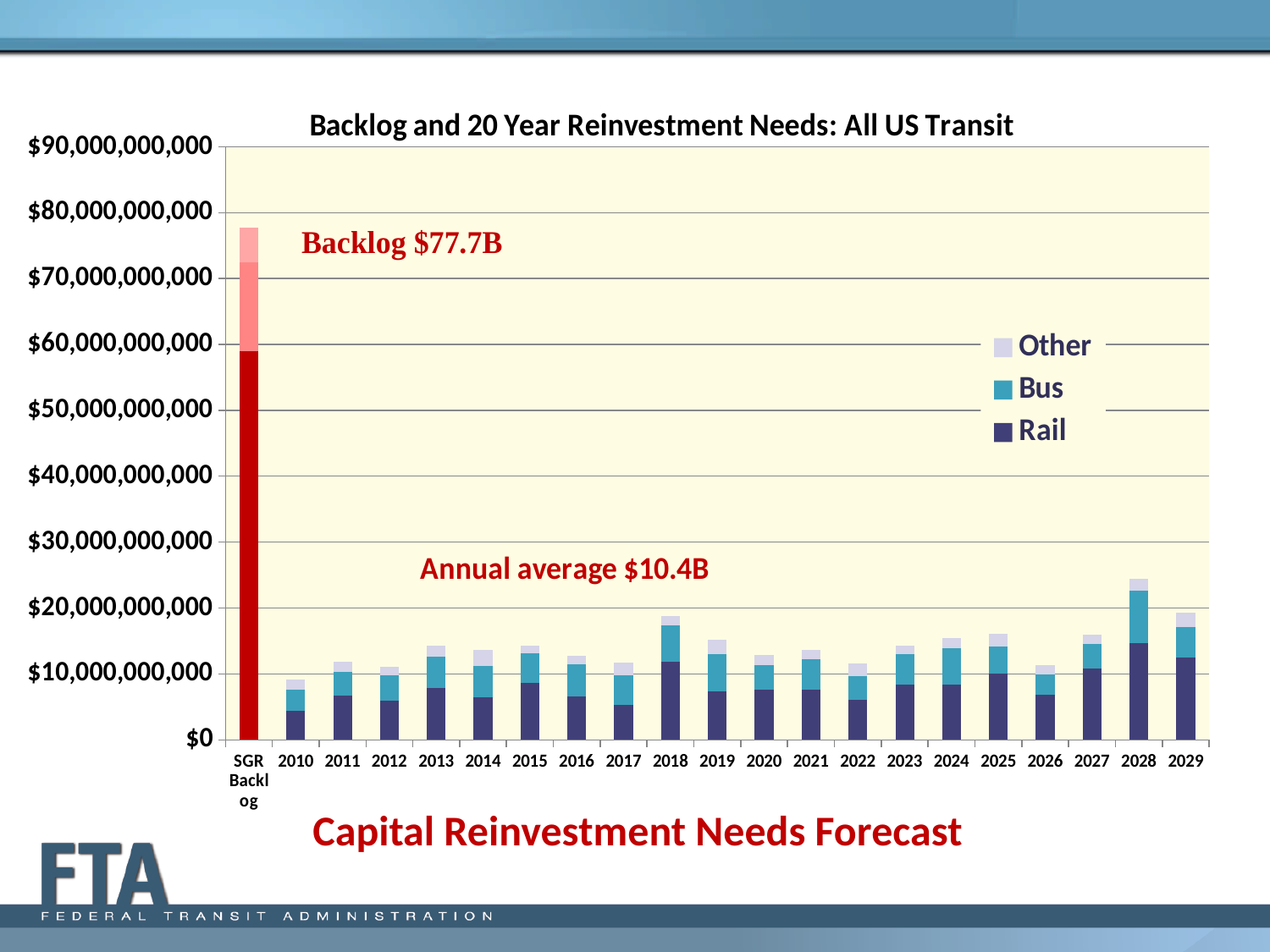
Which year has the tallest stacked bar? 2028 Which series are listed in the legend? Other, Bus, Rail Which year has the shortest stacked bar? 2010 What kind of chart is shown on the slide? Stacked bar chart What value does the chart annotation give for the backlog? $77.7B What annual average value is annotated on the chart? $10.4B Is the total for the SGR Backlog bar greater or less than $70,000,000,000? greater How many year categories (excluding the SGR Backlog bar) are shown on the x axis? 20 Is the total for 2028 greater or less than $20,000,000,000? greater What is the title of the chart? Backlog and 20 Year Reinvestment Needs: All US Transit Which has the larger total, 2018 or 2028? 2028 How many series does the legend list? 3